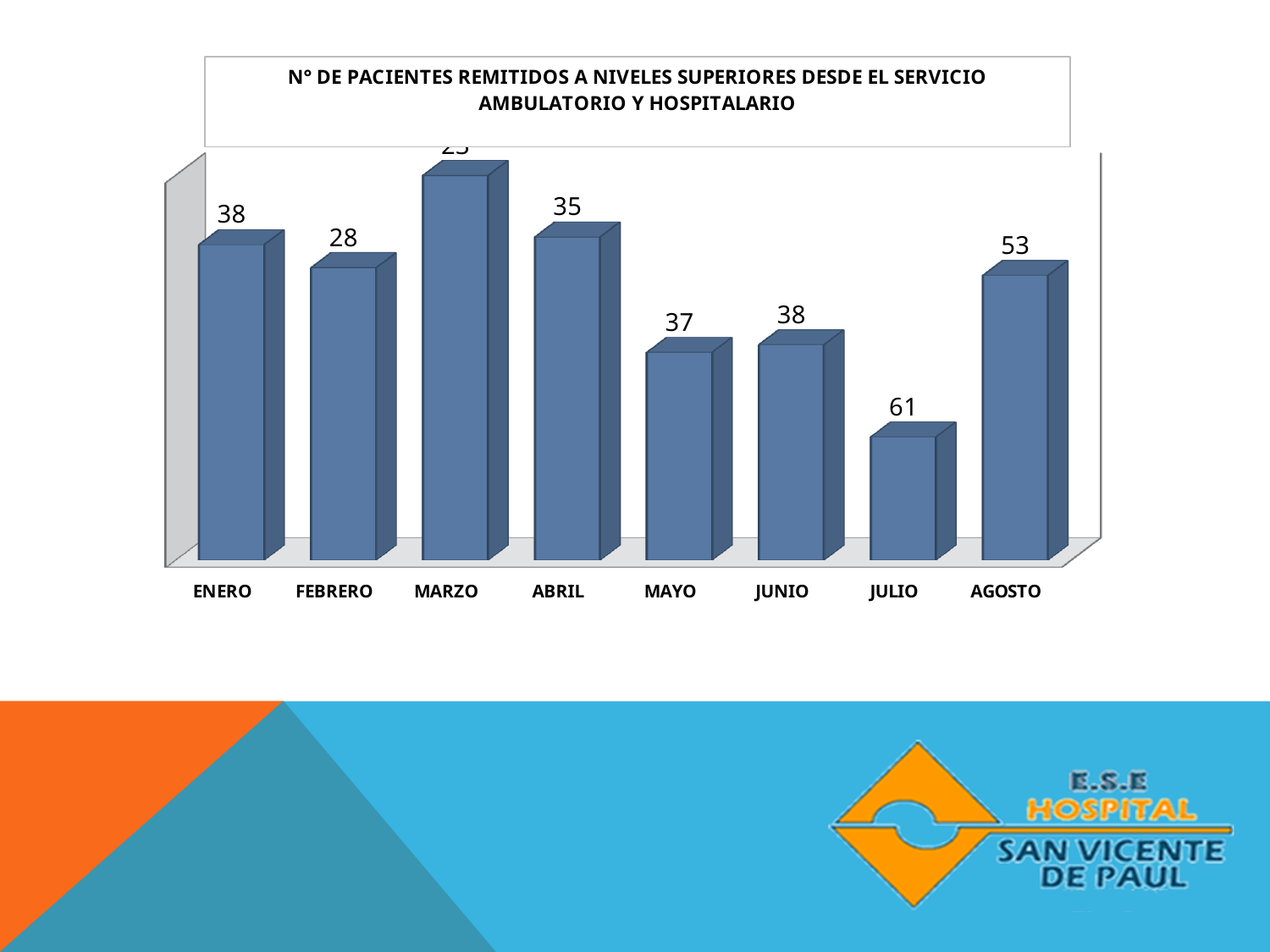
What is the value for AGOSTO? 53 How many months are shown on the x axis? 8 Which is larger, the value for ENERO or the value for FEBRERO? ENERO What is the value for ABRIL? 35 What is the difference between the values for ENERO and FEBRERO? 10 What is the value for FEBRERO? 28 What is the value for JUNIO? 38 What kind of chart is shown on the slide? Bar chart What is the difference between the values for AGOSTO and JUNIO? 15 What is the value for MAYO? 37 What is the value labelled for JULIO? 61 What is the value for ENERO? 38